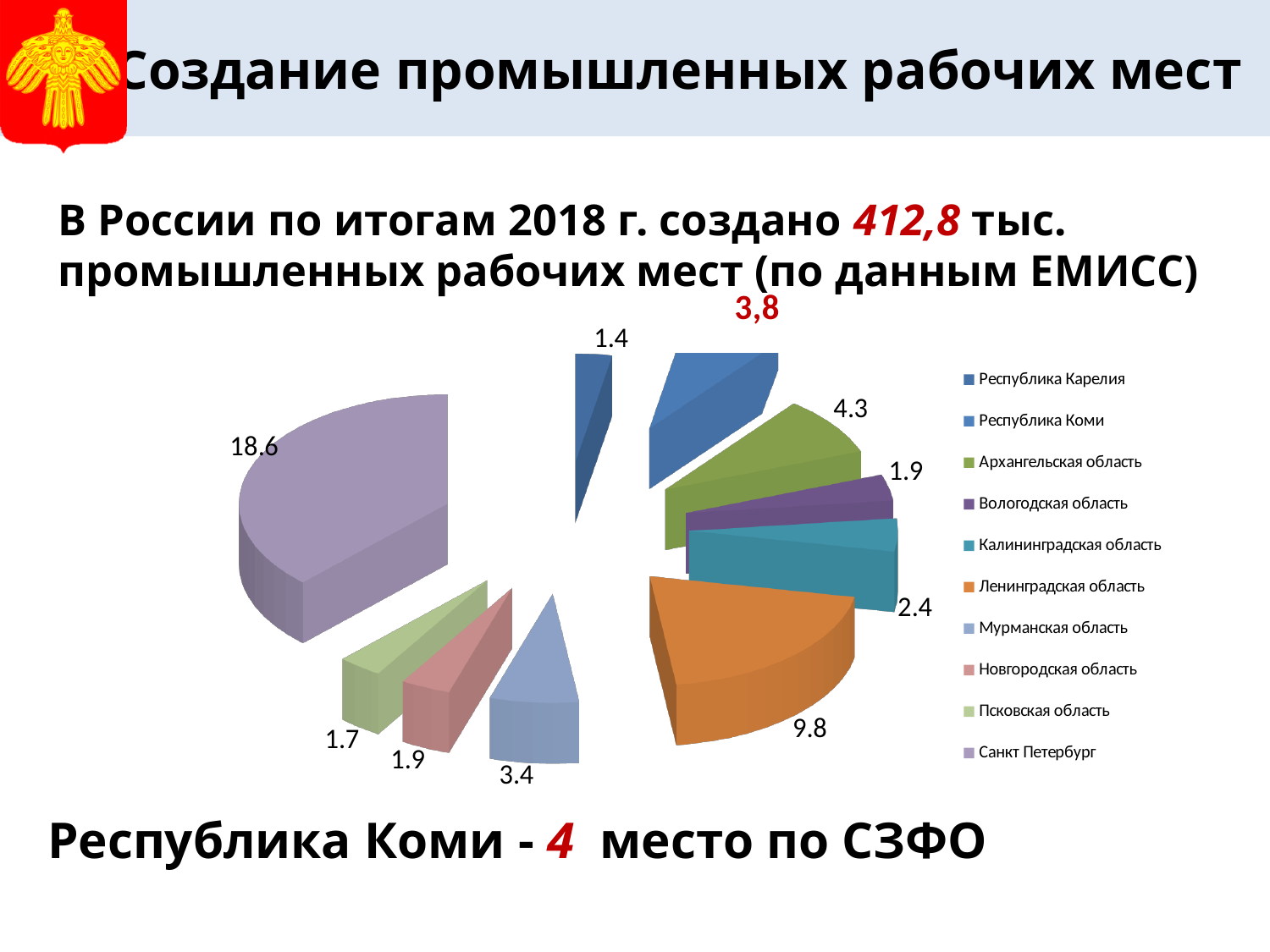
Which region has the smallest slice in the pie chart? Республика Карелия How many regions does the legend of the pie chart list? 10 What value is shown for Республика Коми in the pie chart? 3,8 Which is larger in the pie chart, the value for Калининградская область or the value for Вологодская область? Калининградская область What is the difference between the values for Санкт Петербург and Ленинградская область in the pie chart? 8.8 What value is shown for Мурманская область in the pie chart? 3.4 What value is shown for Ленинградская область in the pie chart? 9.8 What value is shown for Санкт Петербург in the pie chart? 18.6 What kind of chart is shown on the slide? pie chart What value is shown for Архангельская область in the pie chart? 4.3 Which region has the largest slice in the pie chart? Санкт Петербург According to the slide, what place does Республика Коми hold in the СЗФО? 4